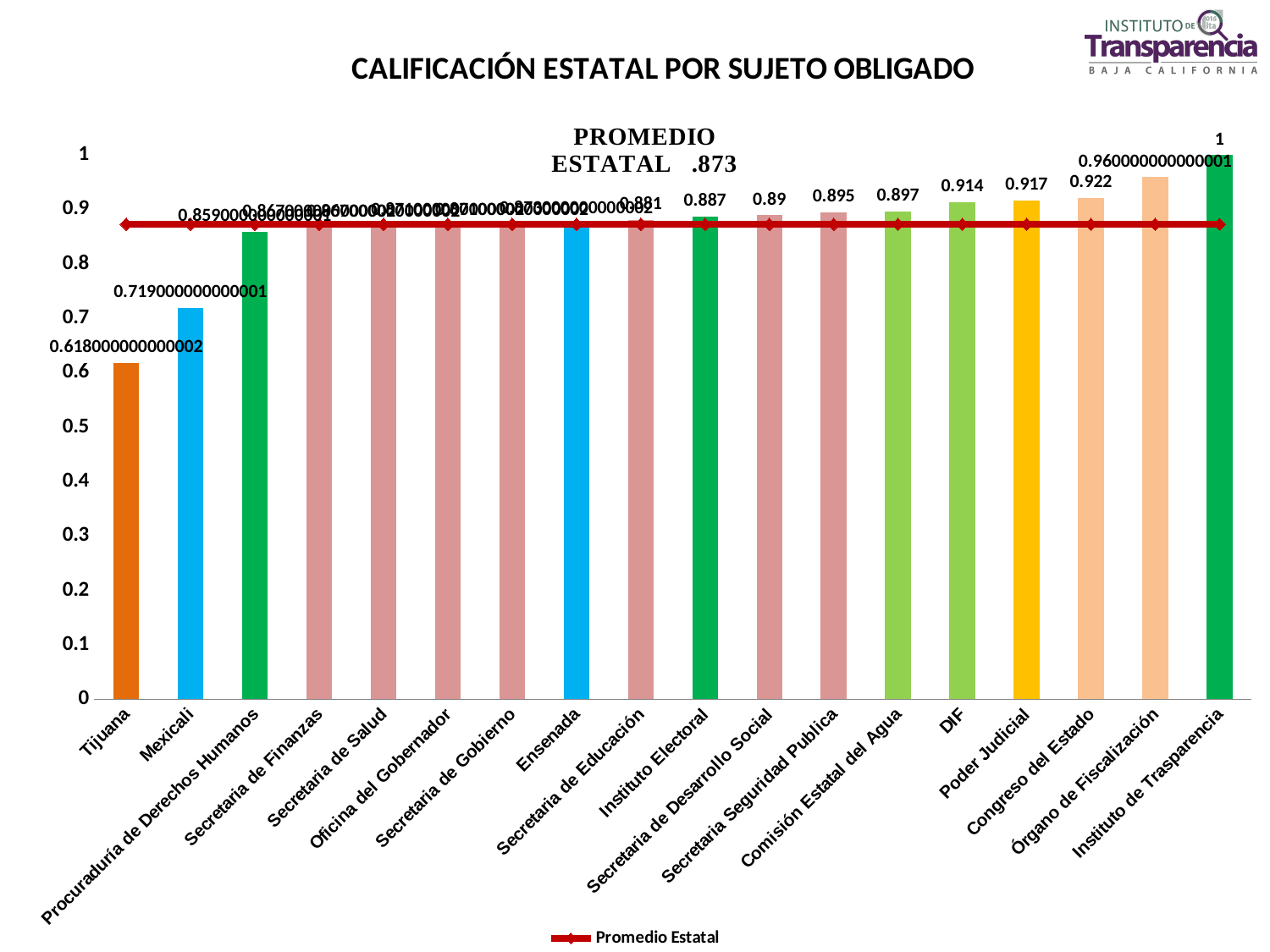
What is the value for Mexicali? 0.719000000000001 What is the value for Instituto de Transparencia? 1 What is the value for DIF? 0.914 How many categories are shown on the x axis? 18 Which is larger, the value for Mexicali or the value for Tijuana? Mexicali Which category has the highest value? Instituto de Transparencia Is the value for Ensenada greater or less than 0.8? greater What is the value for Congreso del Estado? 0.922 Which category has the lowest value? Tijuana What is the value for Tijuana? 0.618000000000002 What is the difference between the values for Poder Judicial and DIF? 0.003 What is the state average (Promedio Estatal) shown on the chart? .873